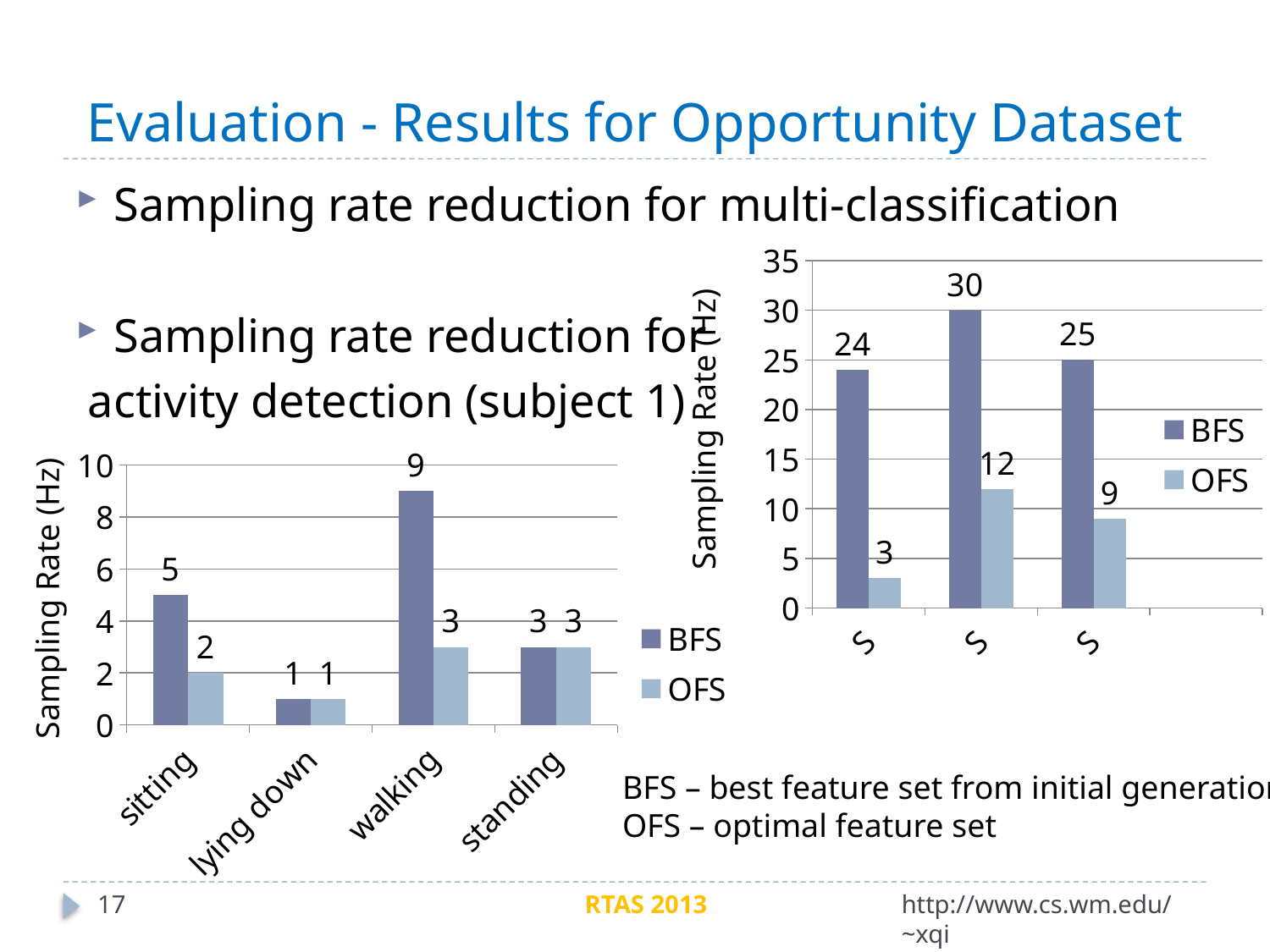
What type of chart is the bottom-left chart (activity detection, subject 1)? Bar chart In the bottom-left chart (activity detection, subject 1), what is the OFS sampling rate for sitting? 2 In the bottom-left chart (activity detection, subject 1), which activity has the highest BFS sampling rate? walking In the bottom-left chart (activity detection, subject 1), how many activity categories are shown? 4 How many series does the legend of the top-right chart list? 2 In the top-right chart (multi-classification), what is the lowest OFS sampling rate shown? 3 In the bottom-left chart (activity detection, subject 1), is the BFS sampling rate for sitting larger than the OFS sampling rate for sitting? Yes In the bottom-left chart (activity detection, subject 1), which activity has the lowest BFS sampling rate? lying down In the top-right chart (multi-classification), what is the difference between the BFS and OFS sampling rates in the second group of bars? 18 In the bottom-left chart (activity detection, subject 1), what is the BFS sampling rate for walking? 9 In the top-right chart (multi-classification), what is the highest BFS sampling rate shown? 30 In the bottom-left chart (activity detection, subject 1), what is the difference between the BFS and OFS sampling rates for walking? 6